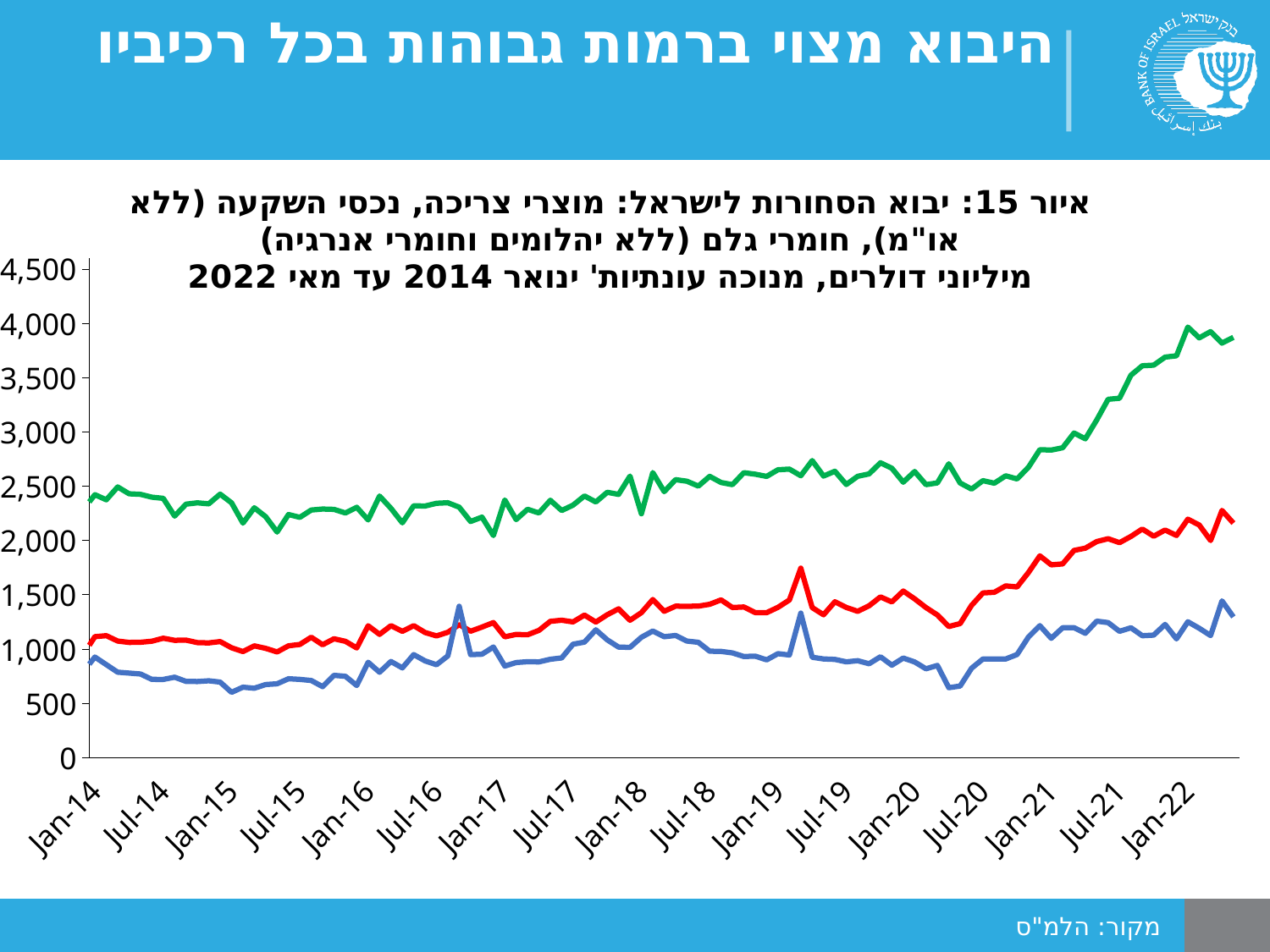
Is the value of the red line at Jan-21 greater or less than 1,500? greater Is the value of the green line at Jan-14 greater or less than 2,000? greater Does the green line overall rise or fall from Jan-14 to Jan-22? rise What kind of chart is shown on the slide? line chart Is the value of the blue line at Jul-20 greater or less than 1,000? less What is the highest value shown on the vertical axis? 4,500 How many lines are plotted on the chart? 3 Which line is the highest across the whole period: the green, red or blue line? green What is the figure number given in the chart title? איור 15 Which line is the lowest across the whole period: the green, red or blue line? blue